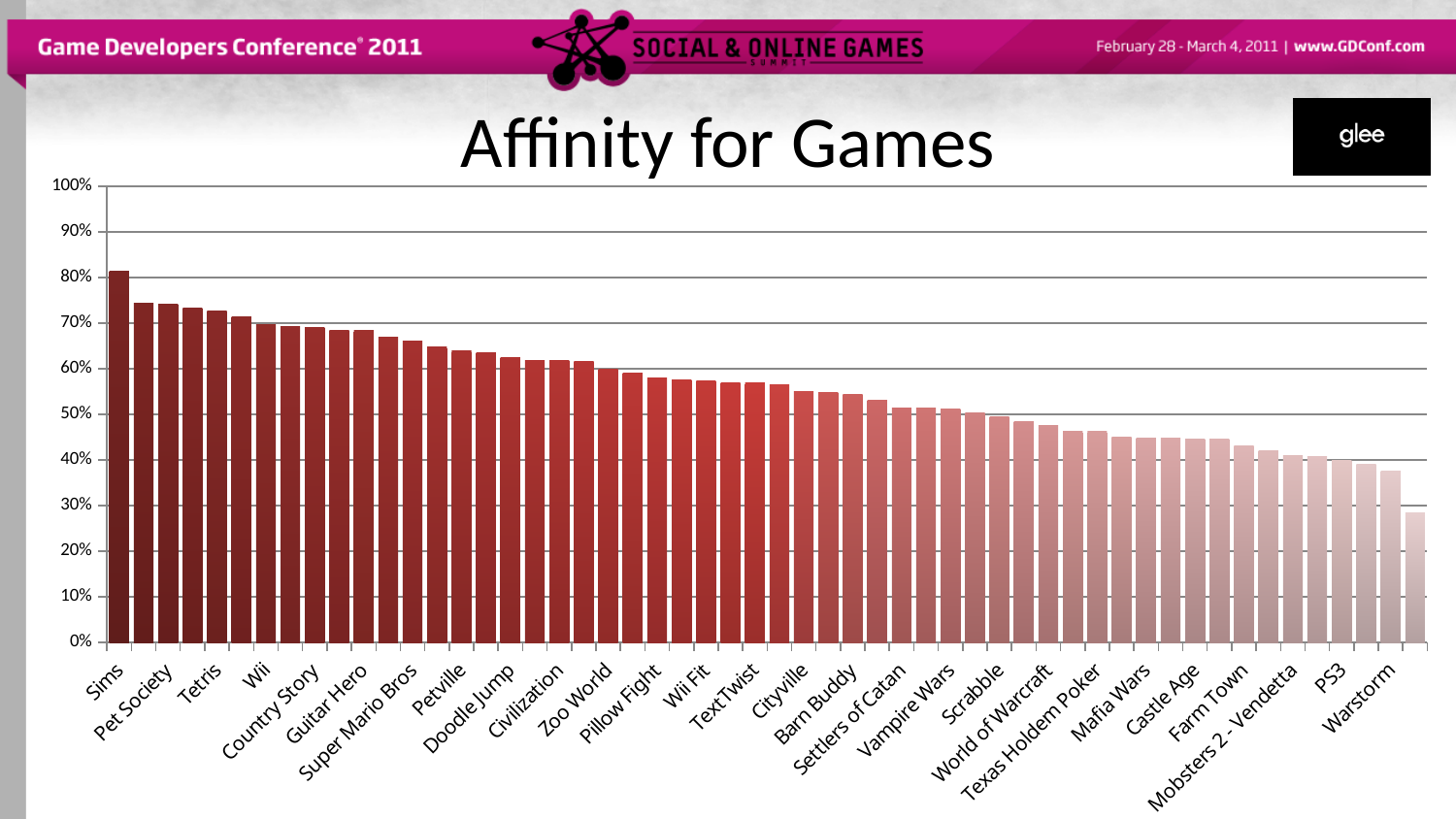
Is the value for Mafia Wars greater or less than 50%? less Is the value for Tetris greater or less than 60%? greater What kind of chart is shown on the slide? bar chart Is the value for Warstorm greater or less than 40%? less Which game has the highest affinity value in the chart? Sims Do the values rise or fall moving from left to right along the x axis? fall Which has a higher value, Guitar Hero or Farm Town? Guitar Hero Which has a higher value, Pet Society or PS3? Pet Society What is the title of the chart? Affinity for Games